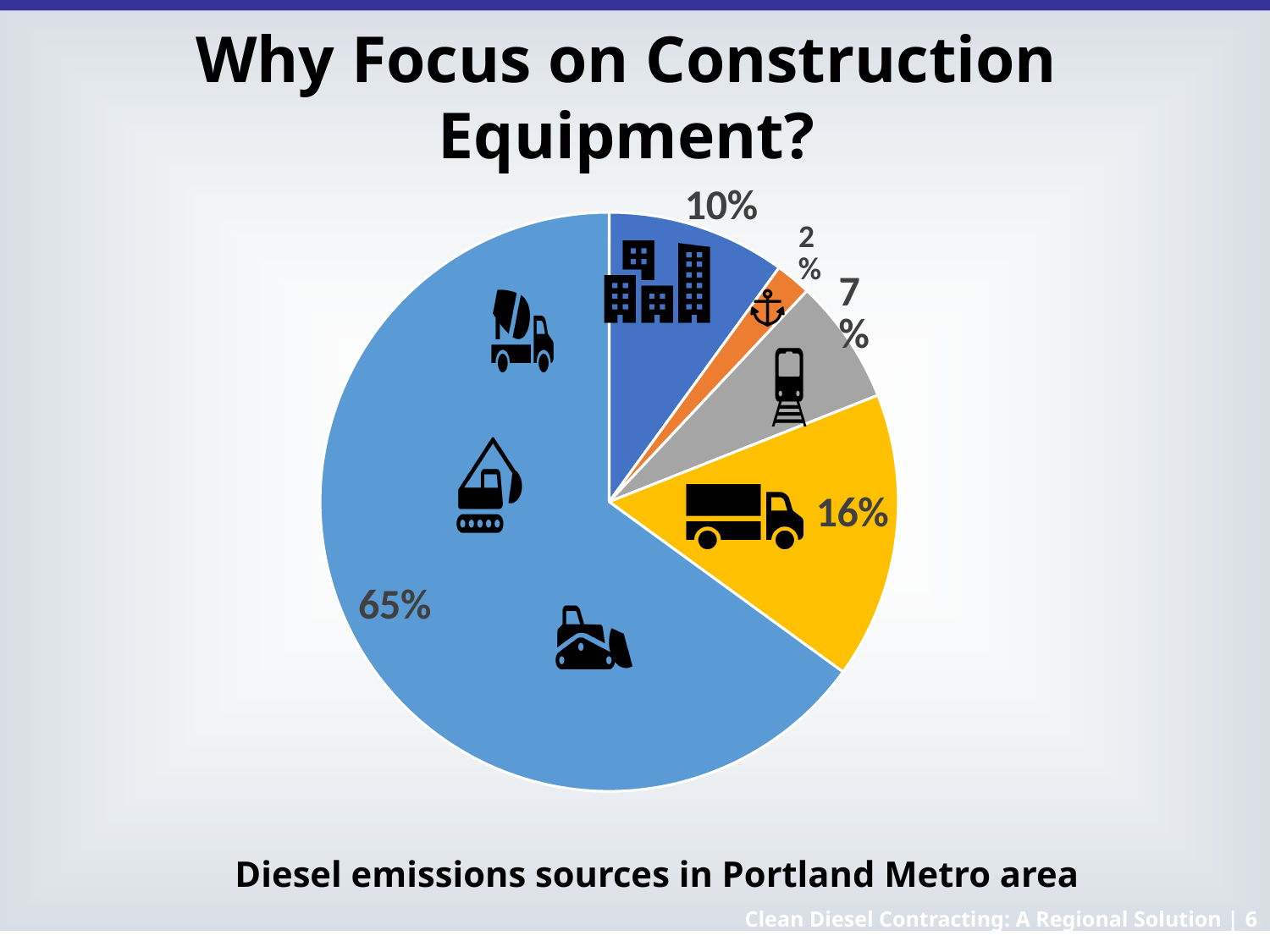
What percentage is shown for the yellow slice with the truck icons? 16% What kind of chart is shown on the slide? pie chart What is the difference in percentage points between the light blue slice (65%) and the yellow slice (16%)? 49 How many slices does the pie chart have? 5 What is the value of the smallest slice of the pie chart? 2% What share of the pie does the light blue slice with the construction equipment icons represent? 65% Which slice is larger: the dark blue slice with the buildings icon or the gray slice with the train icon? the dark blue slice with the buildings icon What caption appears below the pie chart? Diesel emissions sources in Portland Metro area What percentage is shown for the dark blue slice with the buildings icon? 10% What percentage is shown for the gray slice with the train icon? 7% What percentage is shown for the orange slice with the anchor icon? 2% What is the value of the largest slice of the pie chart? 65%